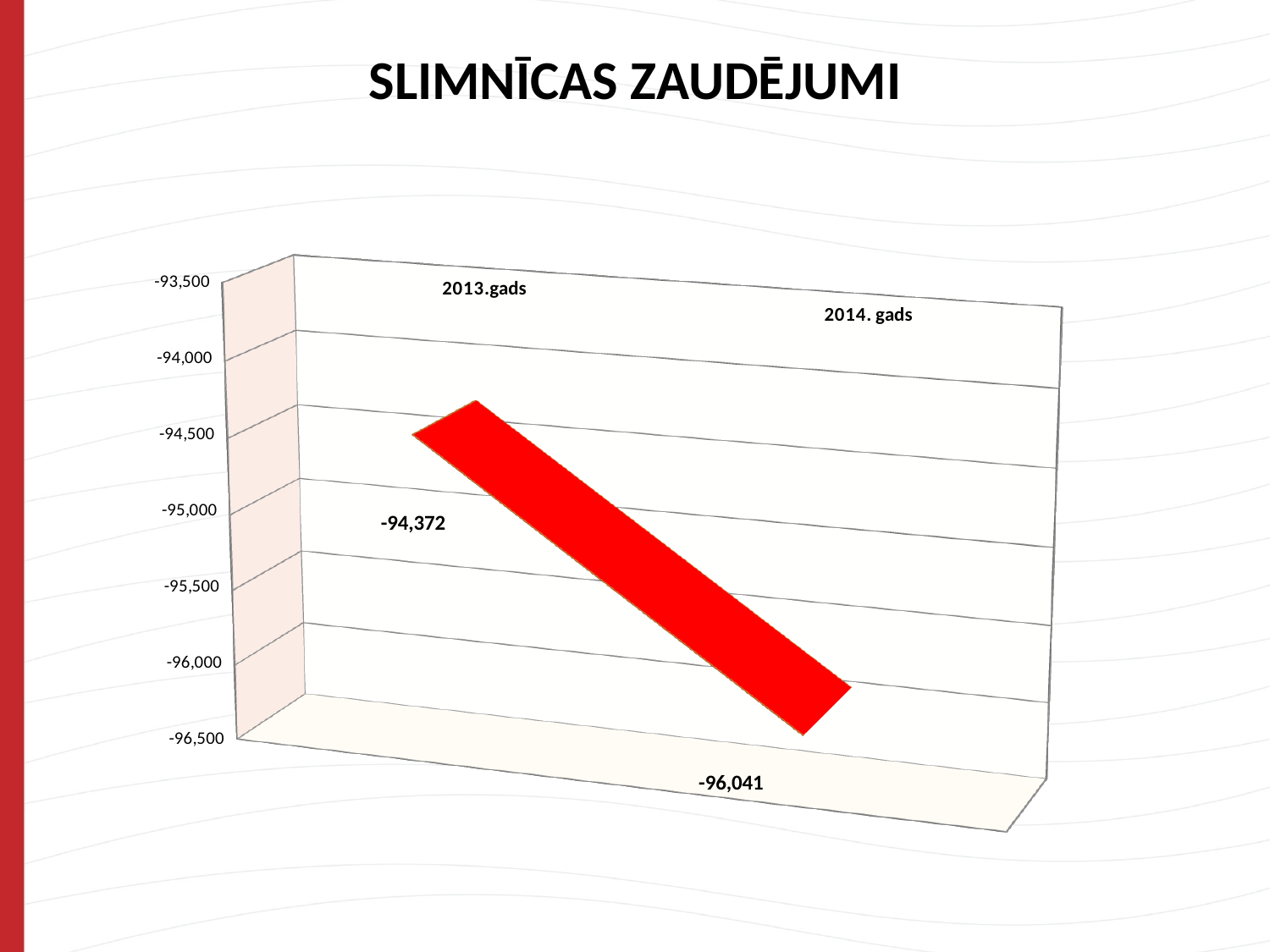
Which year has the higher value? 2013.gads Do the values rise or fall from 2013.gads to 2014. gads? fall Is the value for 2014. gads greater or less than -96,000? less What is the value for 2013.gads? -94,372 What is the title of the chart? SLIMNĪCAS ZAUDĒJUMI Which year has the lowest value? 2014. gads What is the value for 2014. gads? -96,041 Is the value for 2013.gads greater or less than -95,000? greater What kind of chart is shown on the slide? line chart How many data points are plotted on the chart? 2 What is the difference between the values for 2013.gads and 2014. gads? 1,669 Is the value for 2013.gads larger or smaller than the value for 2014. gads? larger